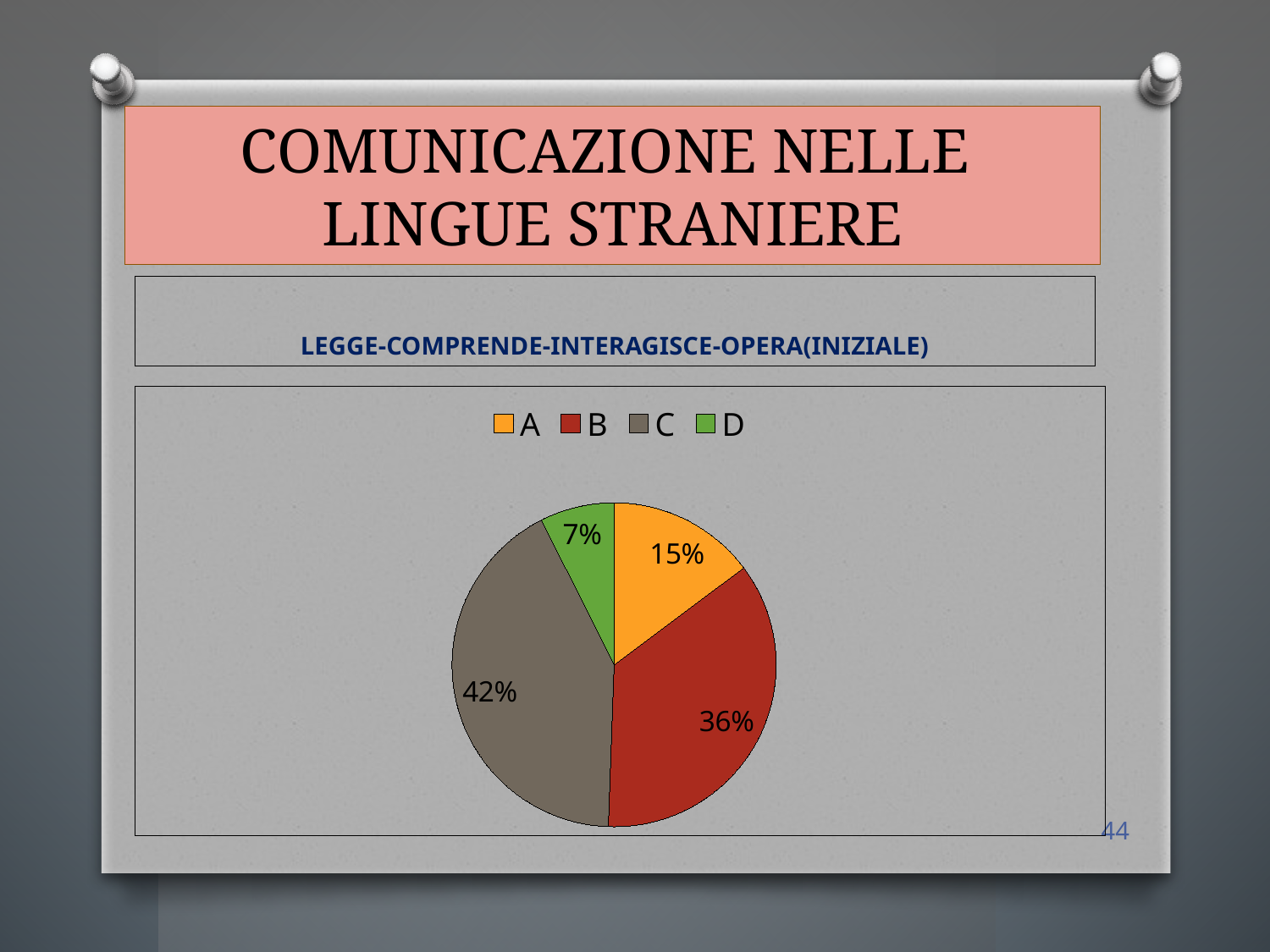
What is the value for category C? 42% Which category has the largest slice? C Which is larger, the value for A or the value for D? A What is the value for category A? 15% What is the value for category D? 7% What is the difference between the values for C and B? 6% What is the value for category B? 36% How many categories does the legend list? 4 What kind of chart is shown on the slide? pie chart What is the chart's title? LEGGE-COMPRENDE-INTERAGISCE-OPERA(INIZIALE) What colour is the slice for category B? red Which category has the smallest slice? D